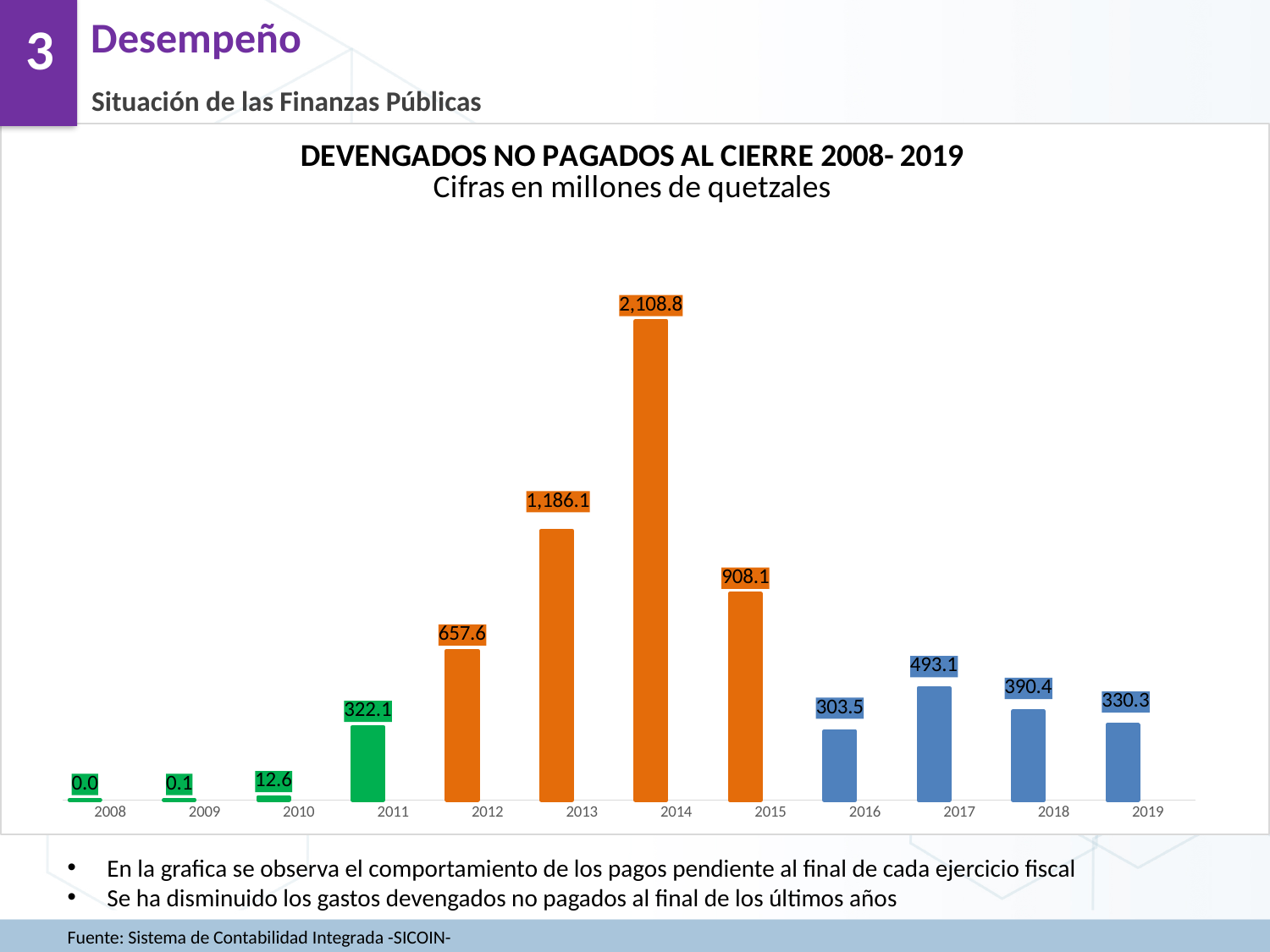
What is the difference between the values for 2018 and 2019? 60.1 What is the value for 2011? 322.1 What is the value for 2017? 493.1 How many years are shown on the x axis? 12 What kind of chart is this? bar chart What is the title of the chart? DEVENGADOS NO PAGADOS AL CIERRE 2008- 2019 Which year has the lowest value? 2008 Which is larger, the value for 2015 or the value for 2012? 2015 Do the values rise or fall from 2017 to 2019? fall What is the difference between the values for 2014 and 2013? 922.7 What is the value for 2014? 2,108.8 Which year has the highest value? 2014